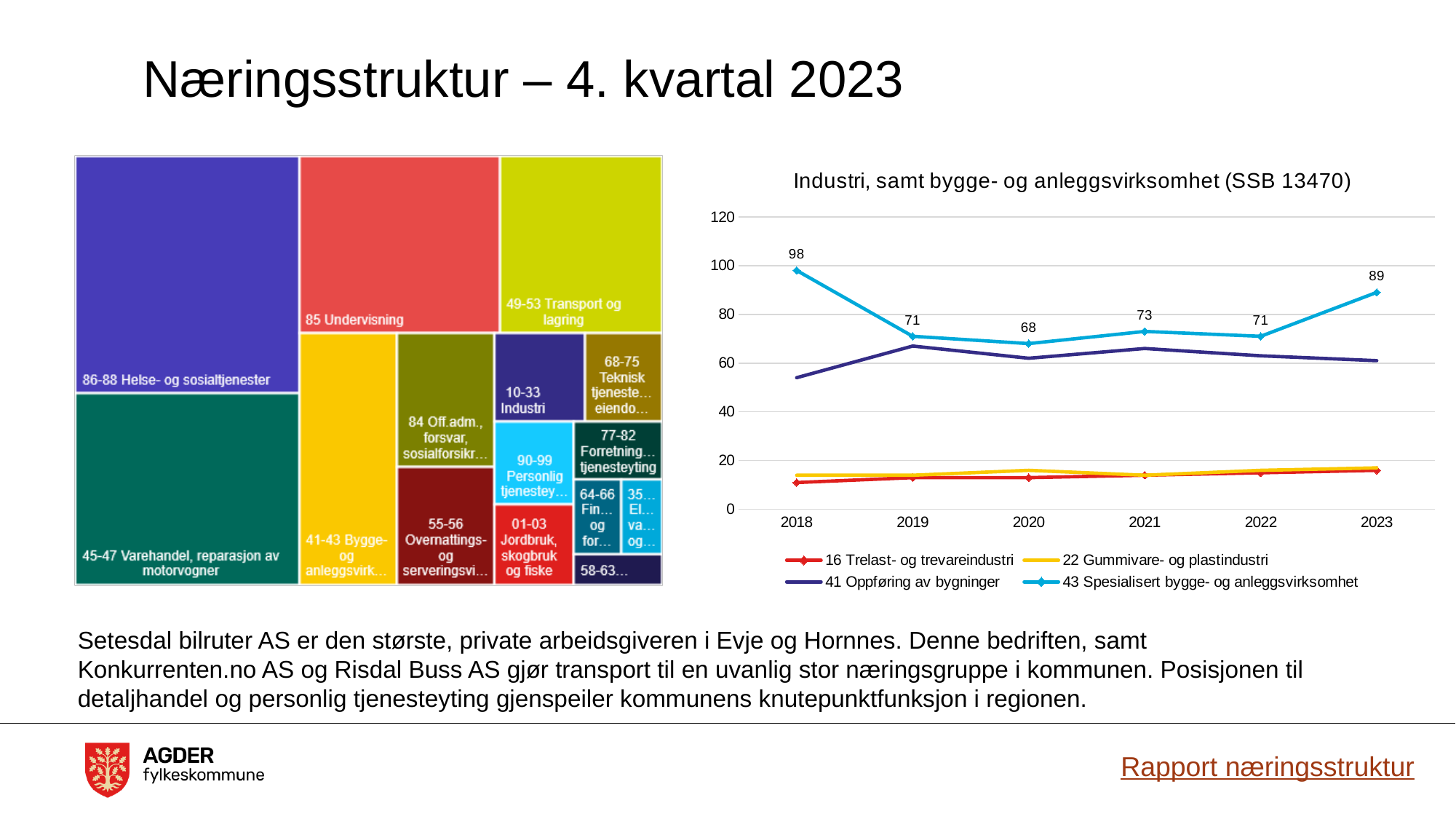
In the line chart on the right, how many series does the legend list? 4 In the line chart on the right, in which year is '43 Spesialisert bygge- og anleggsvirksomhet' lowest? 2020 In the line chart on the right, does '43 Spesialisert bygge- og anleggsvirksomhet' rise or fall from 2018 to 2019? Fall What type of chart is the chart titled 'Industri, samt bygge- og anleggsvirksomhet (SSB 13470)'? Line chart In the line chart on the right, is the value for '41 Oppføring av bygninger' in 2018 greater or less than 60? less In the line chart on the right, what is the value for '43 Spesialisert bygge- og anleggsvirksomhet' in 2023? 89 In the line chart on the right, how many years are shown on the x axis? 6 In the line chart on the right, is the 2021 value for '43 Spesialisert bygge- og anleggsvirksomhet' larger than the 2020 value? Yes, 73 vs 68 In the line chart on the right, what is the difference between the 2018 and 2023 values for '43 Spesialisert bygge- og anleggsvirksomhet'? 9 What is the title of the line chart on the right of the slide? Industri, samt bygge- og anleggsvirksomhet (SSB 13470) In the line chart on the right, what is the value for '43 Spesialisert bygge- og anleggsvirksomhet' in 2018? 98 In the line chart on the right, in which year is '43 Spesialisert bygge- og anleggsvirksomhet' highest? 2018